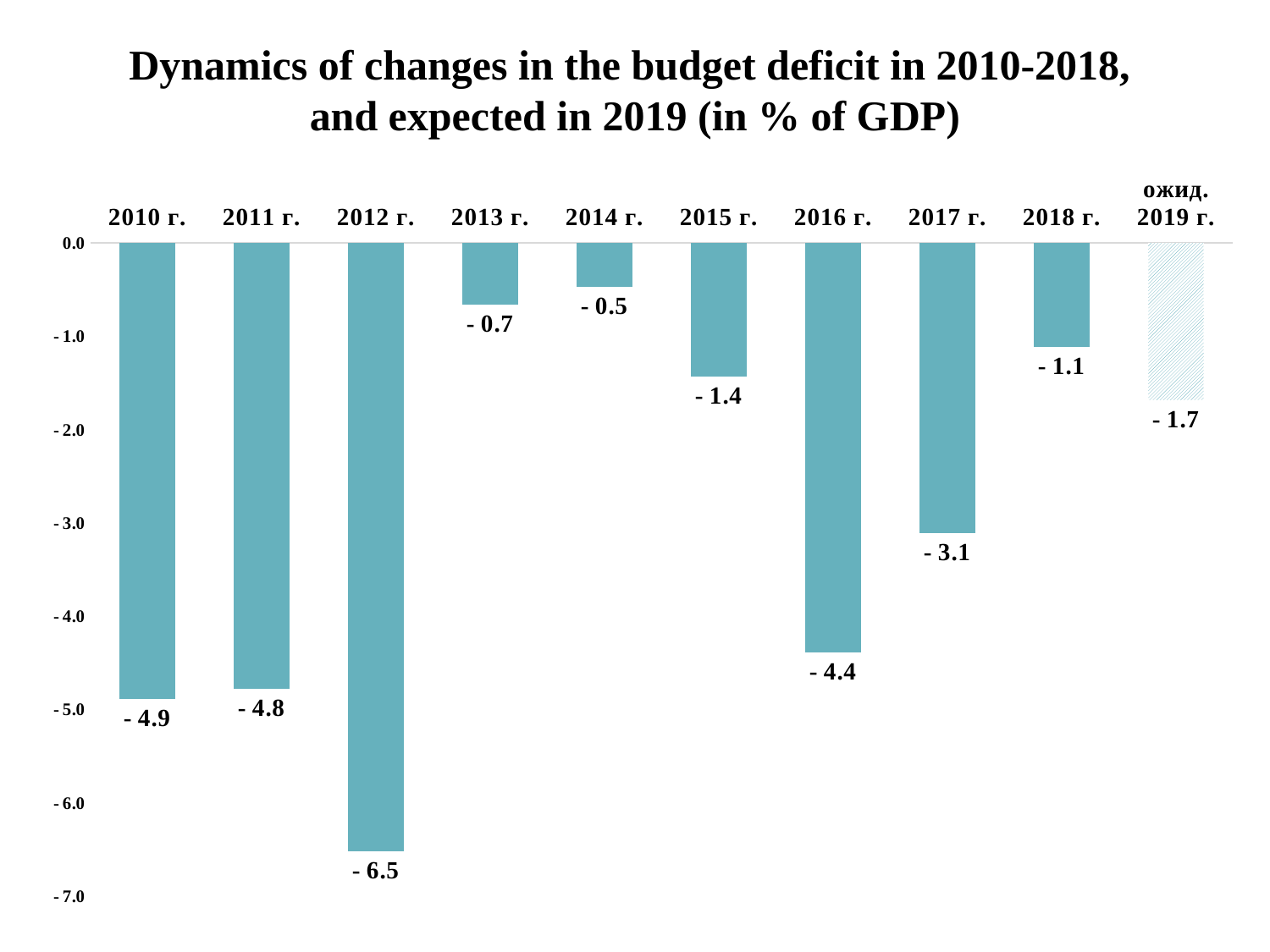
What is the expected value for 2019 г. (ожид. 2019 г.)? - 1.7 What is the difference between the values for 2012 г. and 2016 г.? 2.1 What is the value for 2017 г.? - 3.1 How many bars are shown in the chart? 10 What is the value for 2010 г.? - 4.9 What is the value for 2016 г.? - 4.4 What is the difference between the values for 2017 г. and 2018 г.? 2.0 What kind of chart is this? bar chart Which year has the highest value (the smallest deficit)? 2014 г. Which is larger, the value for 2013 г. or the value for 2015 г.? 2013 г. Which year has the lowest value (the largest deficit)? 2012 г. Do the values rise or fall from 2012 г. to 2014 г.? rise